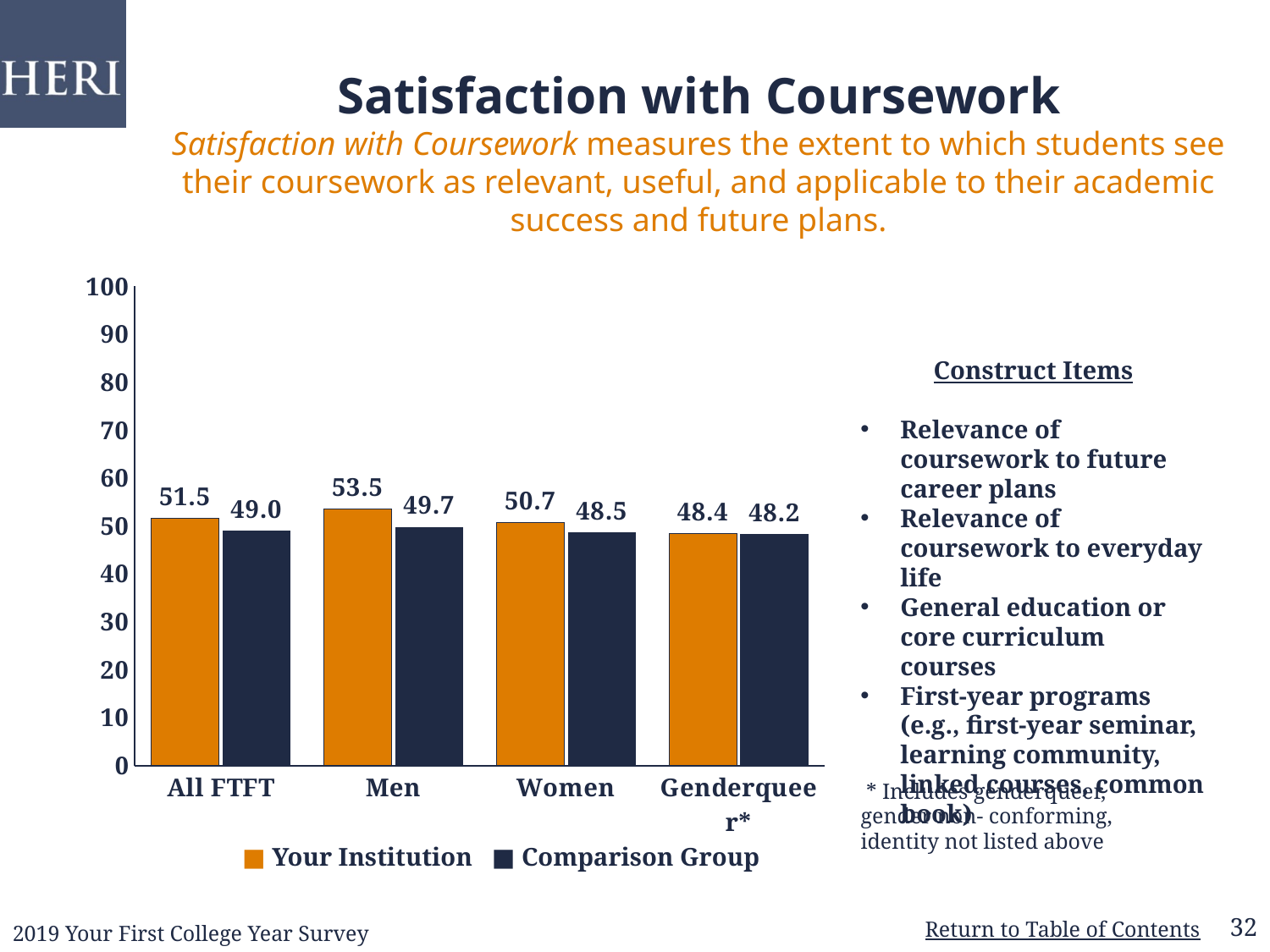
What is the difference between Your Institution and the Comparison Group in the Men category? 3.8 How many series does the legend list? 2 What is the value for the Comparison Group in the Men category? 49.7 In the All FTFT category, which is larger: Your Institution or the Comparison Group? Your Institution Which category has the lowest value for the Comparison Group? Genderqueer* What is the value for Your Institution in the All FTFT category? 51.5 Which category has the highest value for Your Institution? Men Is the value for Your Institution in the Men category greater or less than 50? greater What is the value for Your Institution in the Women category? 50.7 What is the value for the Comparison Group in the Genderqueer* category? 48.2 What kind of chart is shown on the slide? bar chart How many categories are shown on the x axis? 4